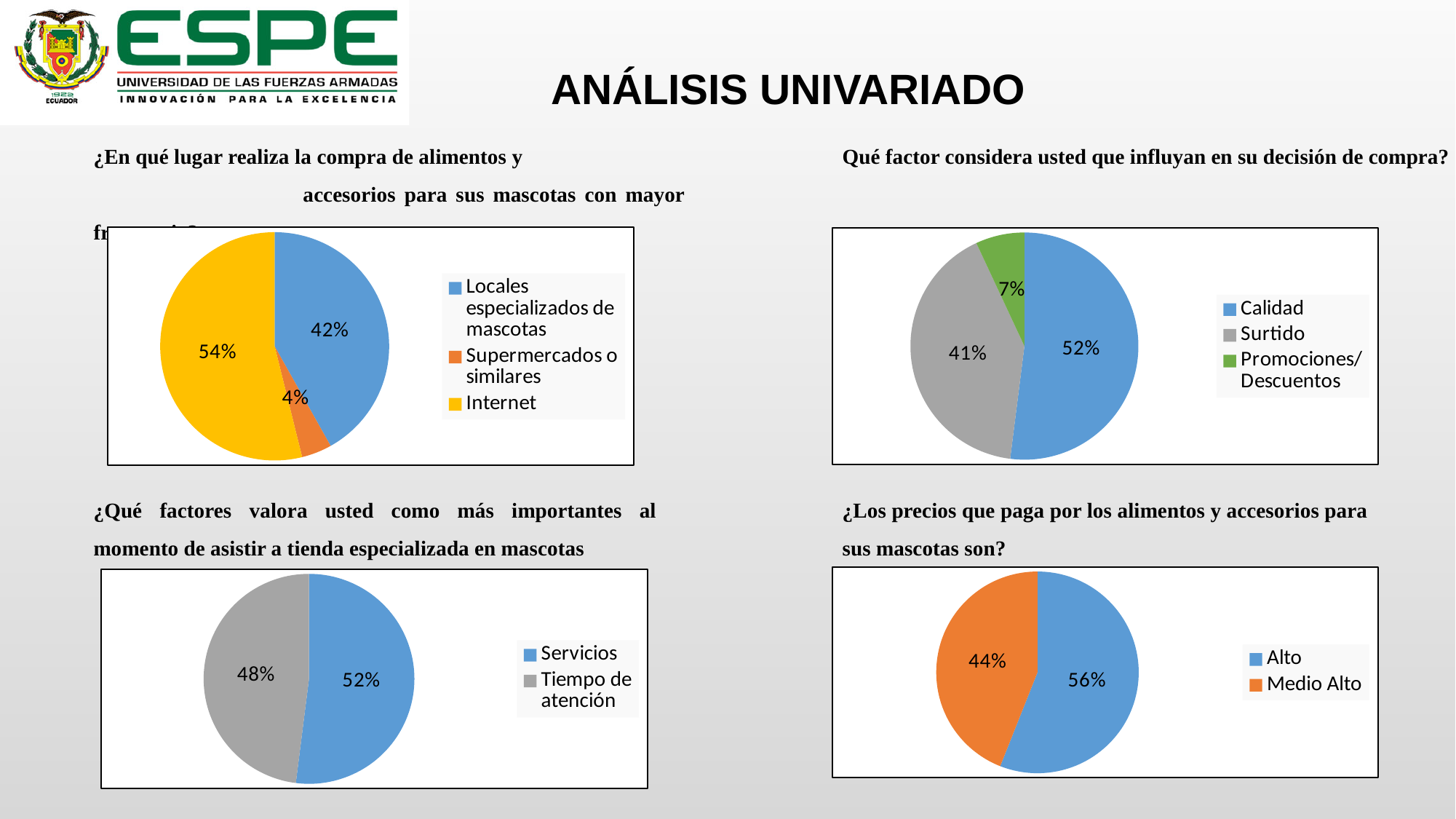
In the bottom-left pie chart, which is larger, Servicios or Tiempo de atención? Servicios In the bottom-right pie chart, what share is labelled for Alto? 56% In the bottom-right pie chart, what is the difference between the shares for Alto and Medio Alto? 12% In the top-left pie chart, how many categories does the legend list? 3 In the top-left pie chart, what share is labelled for Internet? 54% In the top-left pie chart, which category has the largest slice? Internet In the top-left pie chart, what share is labelled for Supermercados o similares? 4% In the top-right pie chart, what is the difference between the shares for Calidad and Surtido? 11% In the top-right pie chart, which category has the smallest slice? Promociones/Descuentos In the bottom-left pie chart, what share is labelled for Tiempo de atención? 48% In the top-right pie chart, what share is labelled for Surtido? 41% What type of chart is the bottom-right chart? Pie chart